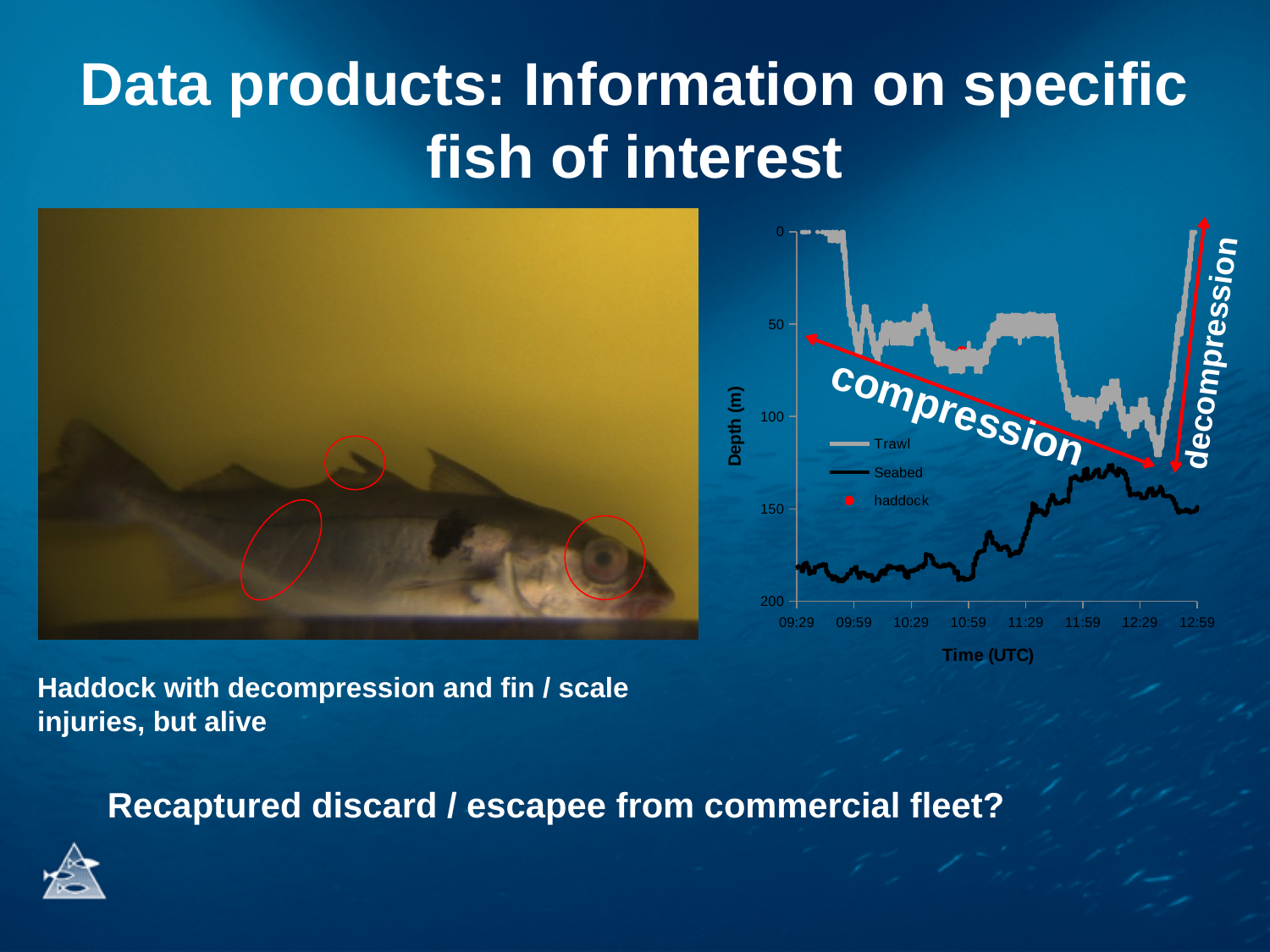
What is the label of the chart's y axis? Depth (m) Is the Trawl depth at 12:29 greater or less than 100 m? greater What kind of chart is shown on the right of the slide? line chart Does the Seabed line get shallower or deeper from 09:29 to 12:59? shallower Is the Seabed depth at 11:59 greater or less than 150 m? less Is the Trawl depth at 12:59 greater or less than 50 m? less What are the three entries in the chart legend? Trawl, Seabed, haddock At 11:29, which series is at a greater depth, Trawl or Seabed? Seabed How many time labels are shown along the chart's x axis? 8 How many series does the chart legend list? 3